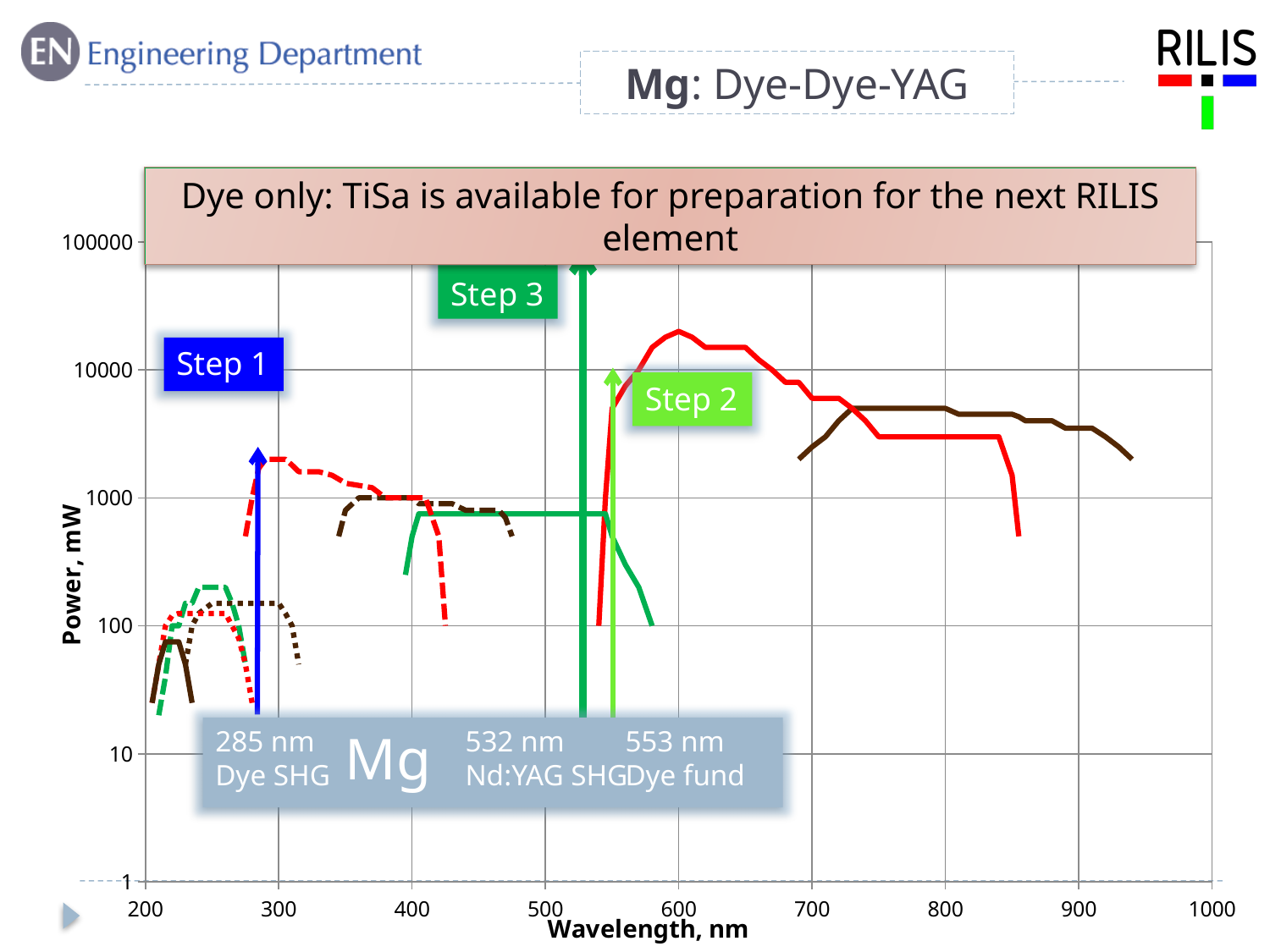
What wavelength is given for Step 1 (Dye SHG)? 285 nm Is the peak power of the solid red curve near 600 nm greater or less than 10000 mW? greater What wavelength is given for the Nd:YAG SHG step? 532 nm Which of the three labelled step wavelengths is the shortest? 285 nm Is the power at the tip of the blue Step 1 arrow at 285 nm greater or less than 1000 mW? greater What kind of chart is shown on the slide? line chart What wavelength is given for the Dye fundamental step? 553 nm Which of the three labelled step wavelengths is the longest? 553 nm What is the label of the y axis? Power, mW What is the highest value shown on the y axis? 100000 What is the difference between the 553 nm and 532 nm step wavelengths? 21 nm What is the title of the slide's chart? Mg: Dye-Dye-YAG